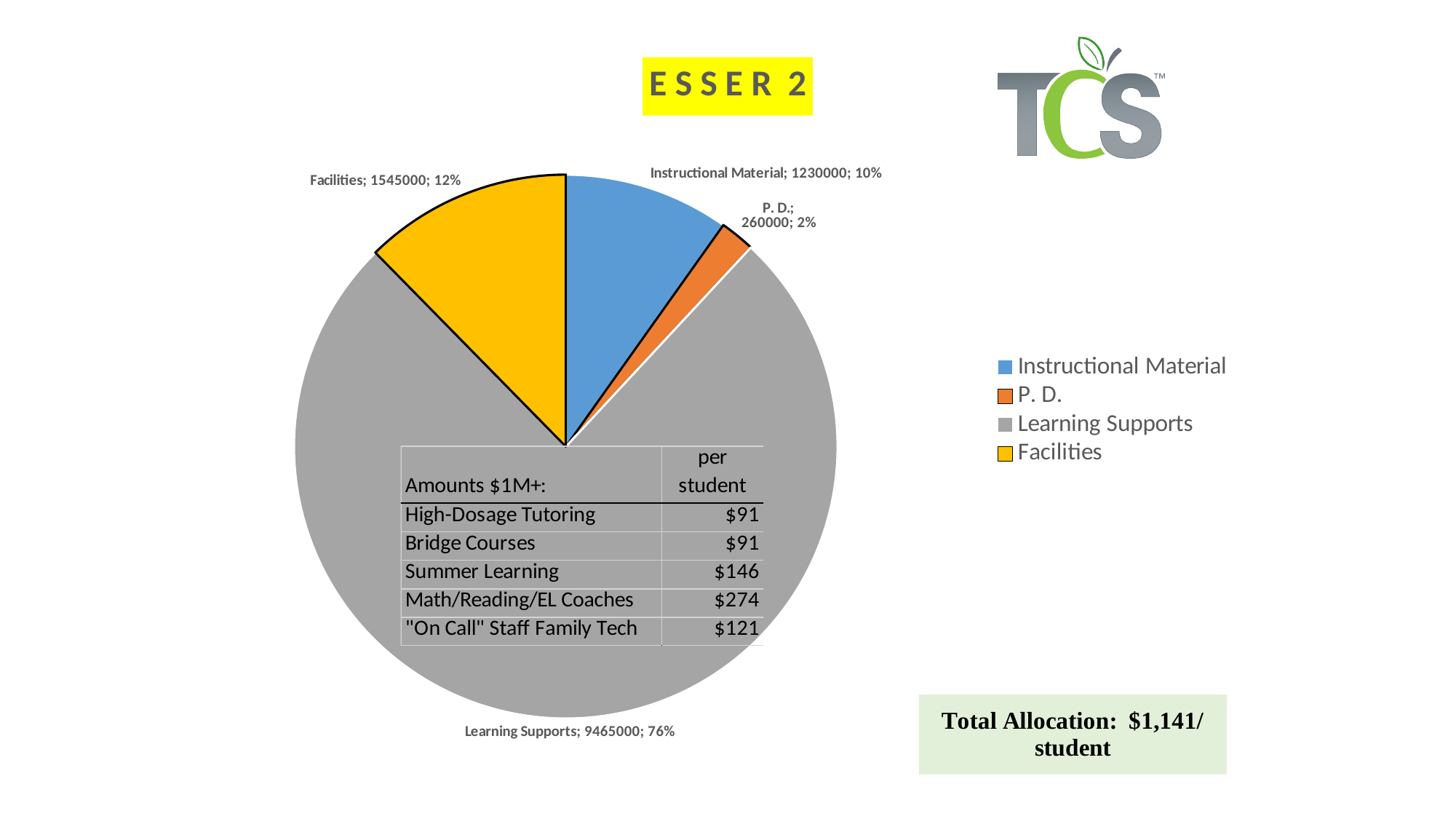
What is the value for Learning Supports in the pie chart? 9465000 Which category has the largest slice of the pie chart? Learning Supports What is the value for Instructional Material in the pie chart? 1230000 Which is larger, the value for Facilities or the value for Instructional Material? Facilities What is the value for Facilities in the pie chart? 1545000 What is the value for P. D. in the pie chart? 260000 What type of chart is shown on the slide? pie chart What is the difference between the Facilities value and the Instructional Material value? 315000 What share of the pie does Instructional Material represent? 10% Which category has the smallest slice of the pie chart? P. D. What share of the pie does Facilities represent? 12% How many categories does the legend of the pie chart list? 4